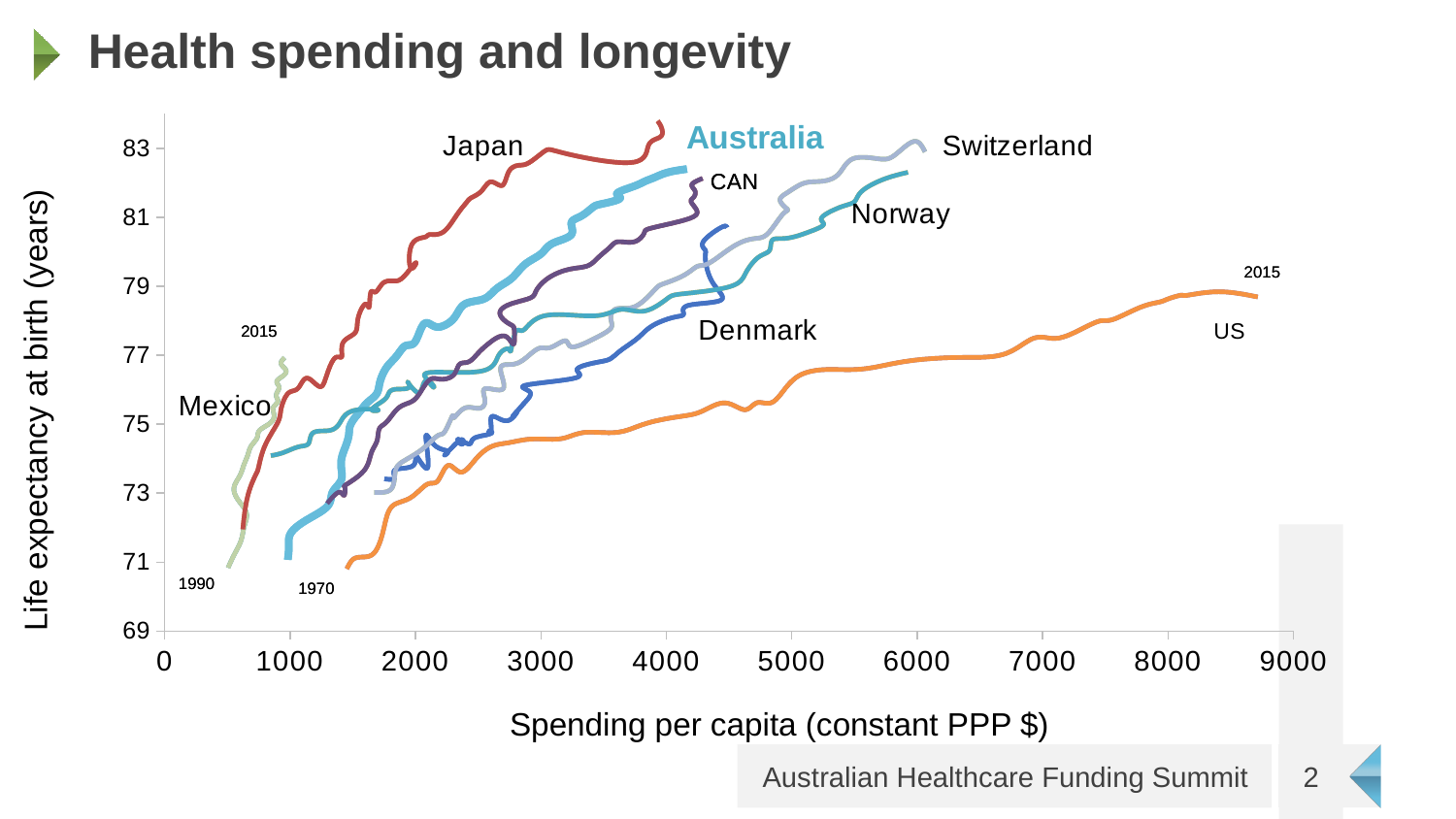
Is the spending per capita at the end of the Norway line greater or less than 5000? greater How many countries are plotted on the chart? 8 Is the spending per capita at the end of the Mexico line greater or less than 1000? less Which country's line stays at the lowest spending per capita? Mexico Which country's line reaches the highest spending per capita? US What kind of chart is shown on the slide? line chart Is the spending per capita at the end of the US line greater or less than 8000? greater What is the label of the x axis? Spending per capita (constant PPP $) As spending per capita increases along the x axis, does life expectancy at birth rise or fall for the countries shown? rise Which country's line reaches the highest life expectancy at birth? Japan At the end of their lines, which country has the higher life expectancy at birth, Japan or the US? Japan